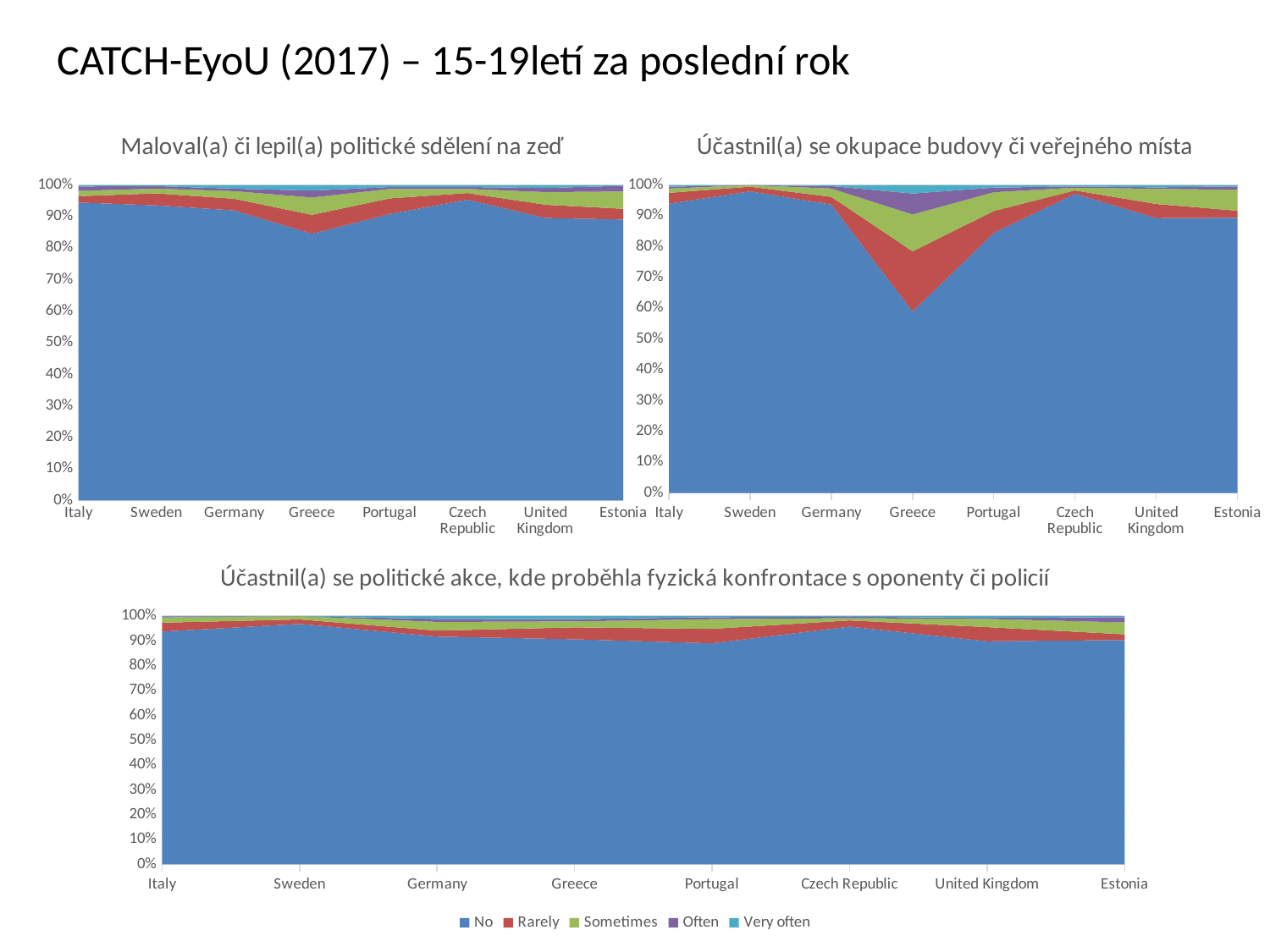
In the chart titled "Účastnil(a) se politické akce, kde proběhla fyzická konfrontace s oponenty či policií", is the "No" share for Estonia greater or less than 80%? greater How many series does the legend at the bottom of the slide list? 5 What is the title of the chart at the bottom of the slide? Účastnil(a) se politické akce, kde proběhla fyzická konfrontace s oponenty či policií In the chart titled "Účastnil(a) se okupace budovy či veřejného místa", which has the larger "No" share, Greece or Czech Republic? Czech Republic In the chart titled "Maloval(a) či lepil(a) politické sdělení na zeď", which country has the lowest share of "No"? Greece What kind of chart is the chart titled "Maloval(a) či lepil(a) politické sdělení na zeď"? Stacked area chart In the chart titled "Účastnil(a) se okupace budovy či veřejného místa", is the "No" share for Greece greater or less than 70%? less How many countries are shown on the x axis of the chart titled "Účastnil(a) se okupace budovy či veřejného místa"? 8 In the chart titled "Maloval(a) či lepil(a) politické sdělení na zeď", is the "No" share for Greece greater or less than 80%? greater Which series is shown in blue in the legend at the bottom of the slide? No In the chart titled "Účastnil(a) se okupace budovy či veřejného místa", which country has the lowest share of "No"? Greece